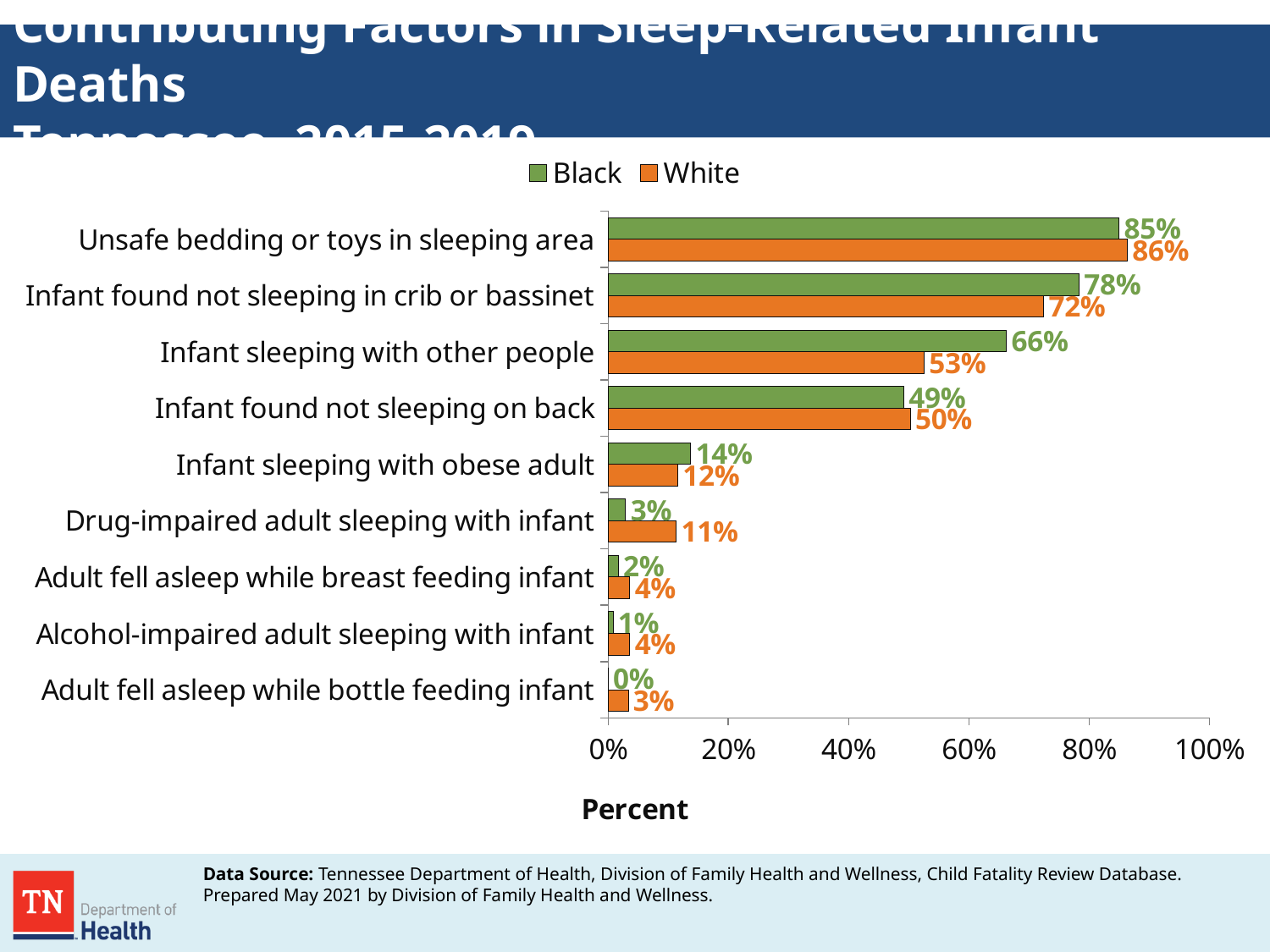
Which category has the highest value for the White series? Unsafe bedding or toys in sleeping area Is the Black value for "Infant found not sleeping on back" greater or less than 60%? less Which category has the lowest value for the Black series? Adult fell asleep while bottle feeding infant What type of chart is shown on the slide? Bar chart What is the value for White for "Drug-impaired adult sleeping with infant"? 11% What is the value for White for "Infant found not sleeping in crib or bassinet"? 72% What is the difference between the White and Black values for "Drug-impaired adult sleeping with infant"? 8% What is the value for Black for "Infant sleeping with other people"? 66% For "Infant found not sleeping in crib or bassinet", which series has the larger value, Black or White? Black What is the difference between the Black and White values for "Infant sleeping with other people"? 13% How many categories are shown on the chart? 9 How many series does the legend list? 2